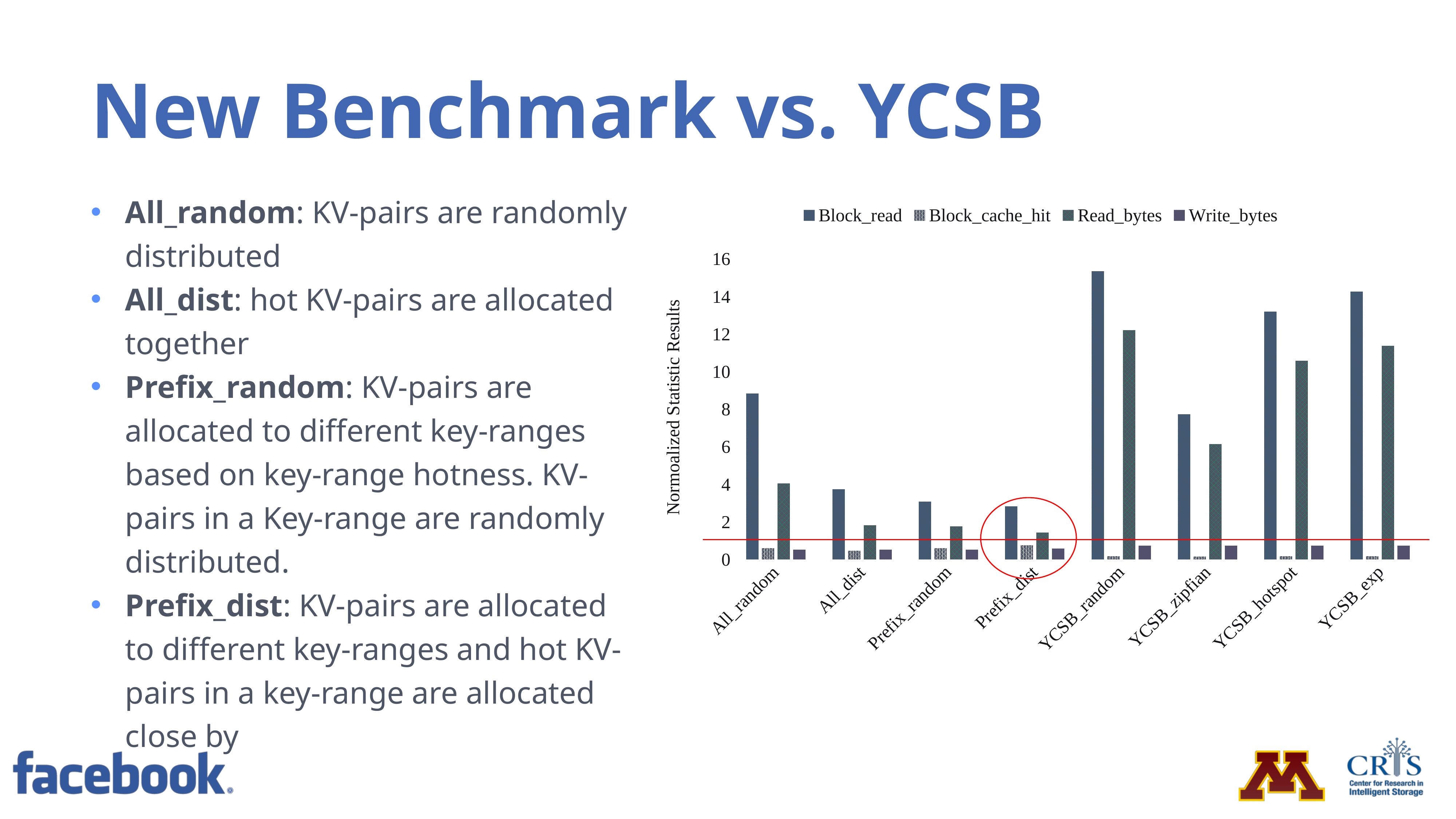
What kind of chart is shown on the slide? bar chart Which is larger, the Block_read value for All_random or for YCSB_zipfian? All_random Is the Block_read value for All_random greater or less than 8? greater Which category on the chart is highlighted with a red circle? Prefix_dist Is the Read_bytes value for YCSB_random greater or less than 10? greater Which is larger, the Read_bytes value for All_random or for All_dist? All_random How many series does the chart's legend list? 4 Is the Read_bytes value for YCSB_zipfian greater or less than 8? less Which category has the highest Read_bytes value? YCSB_random Which category has the highest Block_read value? YCSB_random How many categories are shown on the x axis of the chart? 8